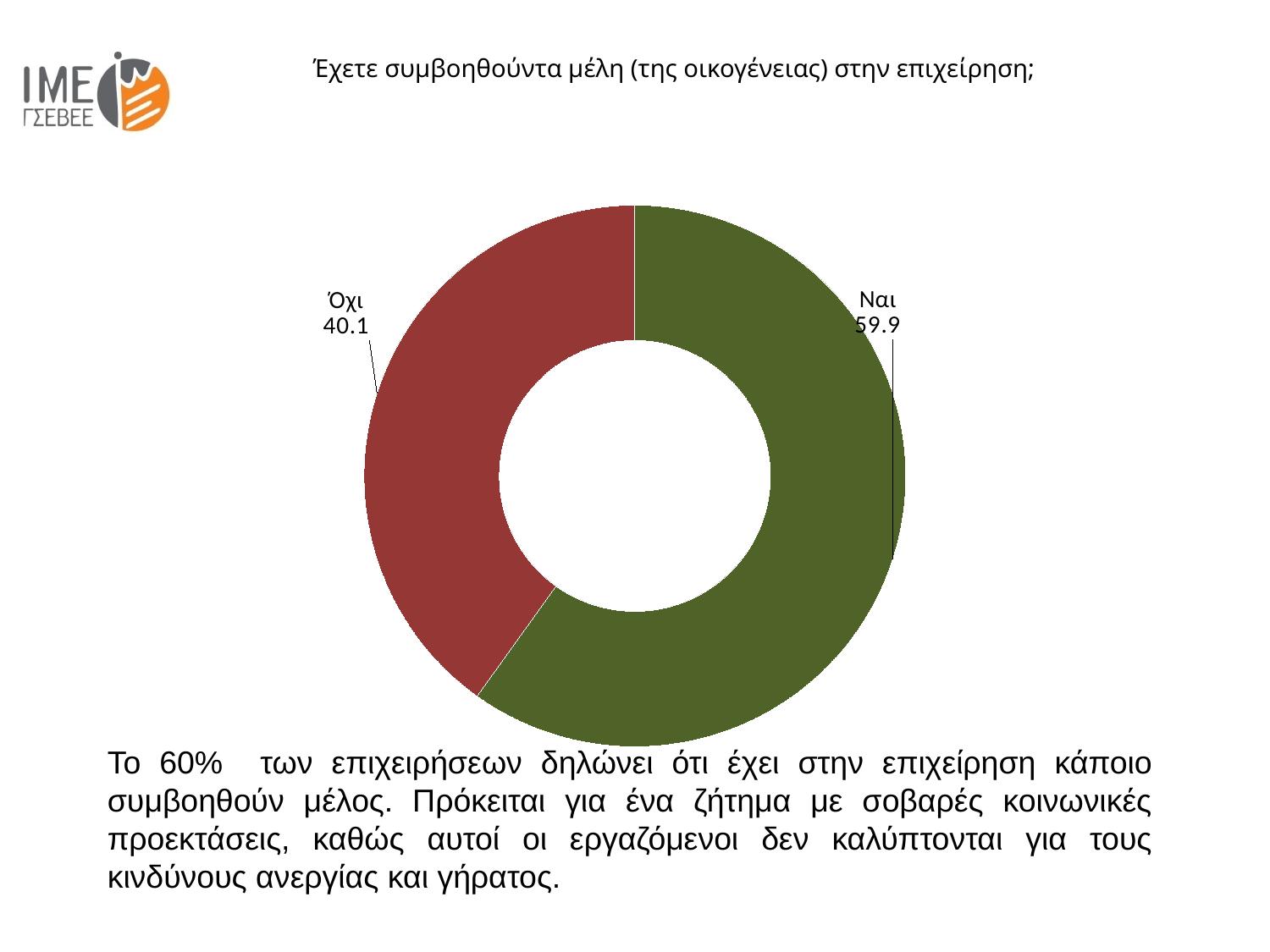
What is the title of the chart? Έχετε συμβοηθούντα μέλη (της οικογένειας) στην επιχείρηση; Which category has the smallest slice? Όχι What kind of chart is shown on the slide? Doughnut (pie) chart What colour is the 'Όχι' slice? Red What is the difference between the 'Ναι' and 'Όχι' values? 19.8 What is the total of the two slice values? 100 How many slices does the chart have? 2 What value is shown for the 'Όχι' slice? 40.1 What value is shown for the 'Ναι' slice? 59.9 Which category has the largest slice? Ναι Which is larger, the 'Ναι' slice or the 'Όχι' slice? Ναι